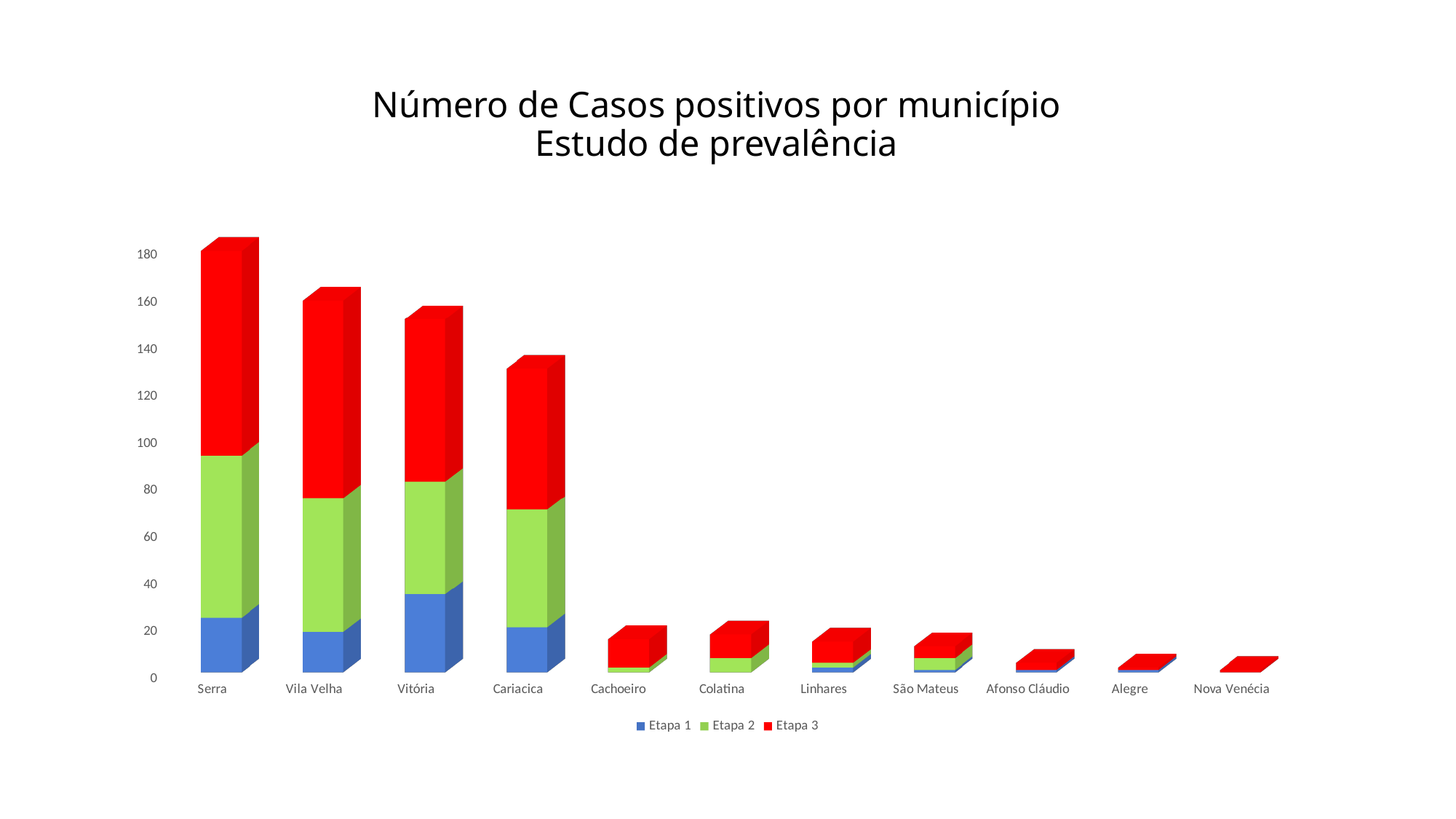
How many series does the chart legend list? 3 Which has a larger total of positive cases, Cachoeiro or Vitória? Vitória Which municipality has the lowest total number of positive cases? Nova Venécia Which municipality has the highest total number of positive cases? Serra Is the total value for Cariacica greater or less than 140? less What kind of chart is shown on the slide? Stacked bar chart Is the total value for Serra greater or less than 160? greater Is the total value for Cachoeiro greater or less than 40? less Which has a larger total of positive cases, Serra or Cariacica? Serra Do the total values generally rise or fall from left to right along the x axis? Fall Which colour represents Etapa 3 in the chart legend? Red How many municipalities are shown on the x axis of the chart? 11